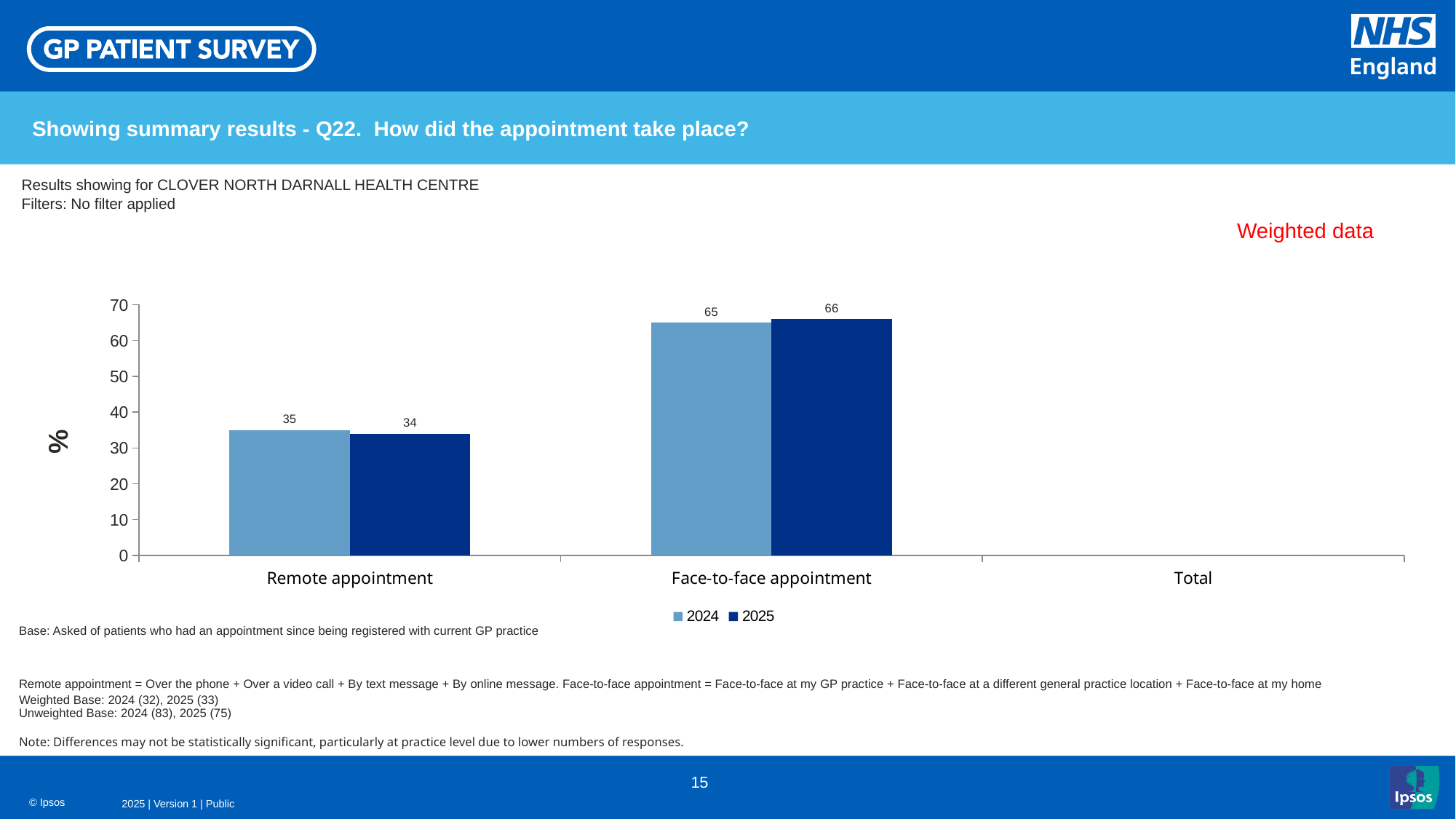
What is the value for Face-to-face appointment in 2024? 65 What label is shown on the vertical axis of the chart? % What is the value for Remote appointment in 2025? 34 Which category has the highest value in 2025? Face-to-face appointment What is the difference between the Face-to-face appointment and Remote appointment values in 2024? 30 How many series does the legend list? 2 What is the value for Face-to-face appointment in 2025? 66 What is the value for Remote appointment in 2024? 35 Is the value for Face-to-face appointment in 2025 greater or less than 60? greater What is the difference between the 2024 and 2025 values for Remote appointment? 1 What kind of chart is shown on the slide? Bar chart Which is larger: the 2024 value for Face-to-face appointment or the 2025 value for Face-to-face appointment? 2025